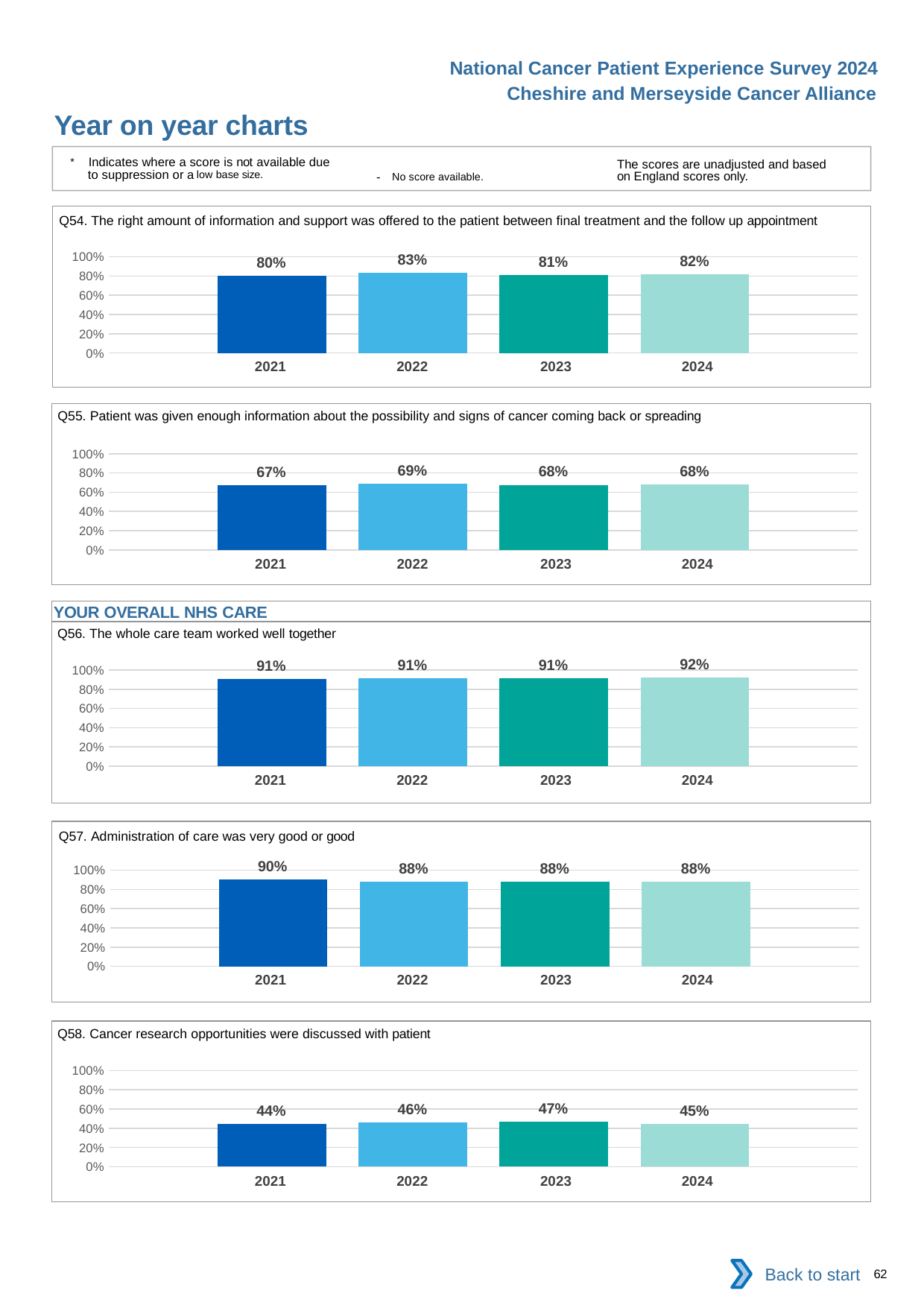
What kind of chart is the Q58 chart? Bar chart In the Q55 chart, what is the difference between the 2022 value and the 2021 value? 2% In the Q56 chart, how many years are plotted? 4 In the Q58 chart, what is the value for 2023? 47% In the Q57 chart, what is the value for 2021? 90% In the Q57 chart, is the value for 2021 larger than the value for 2024? Yes, 2021 In the Q54 chart, what is the value for 2022? 83% What is the section heading shown above the Q56 chart? YOUR OVERALL NHS CARE In the Q56 chart, which year has the highest value? 2024 In the Q54 chart, which year has the lowest value? 2021 In the Q55 chart, what is the value for 2021? 67% In the Q58 chart, is the value for 2024 greater or less than 60%? less